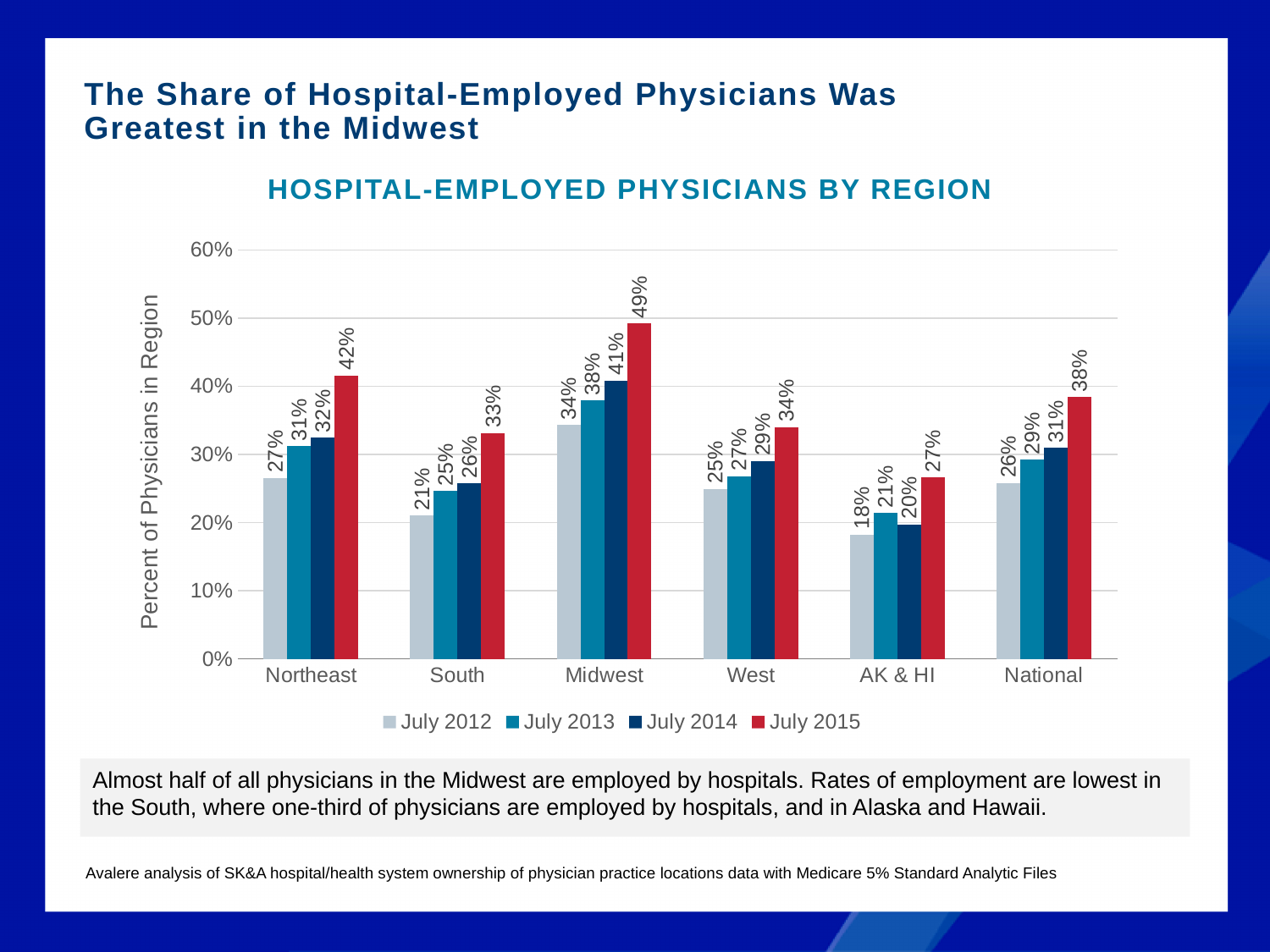
What is the value for the Midwest in July 2015? 49% How many regions are shown on the x axis? 6 Which region has the lowest value in July 2013? AK & HI Which region has the highest value in July 2015? Midwest What is the National value for July 2014? 31% What kind of chart is shown? Bar chart Which is larger: the Northeast value in July 2015 or the West value in July 2015? Northeast What is the difference between the Midwest and the South in July 2015? 16% What is the title of the chart? Hospital-Employed Physicians by Region How many series does the legend list? 4 Do the values for the South rise or fall from July 2012 to July 2015? Rise What is the value for AK & HI in July 2012? 18%